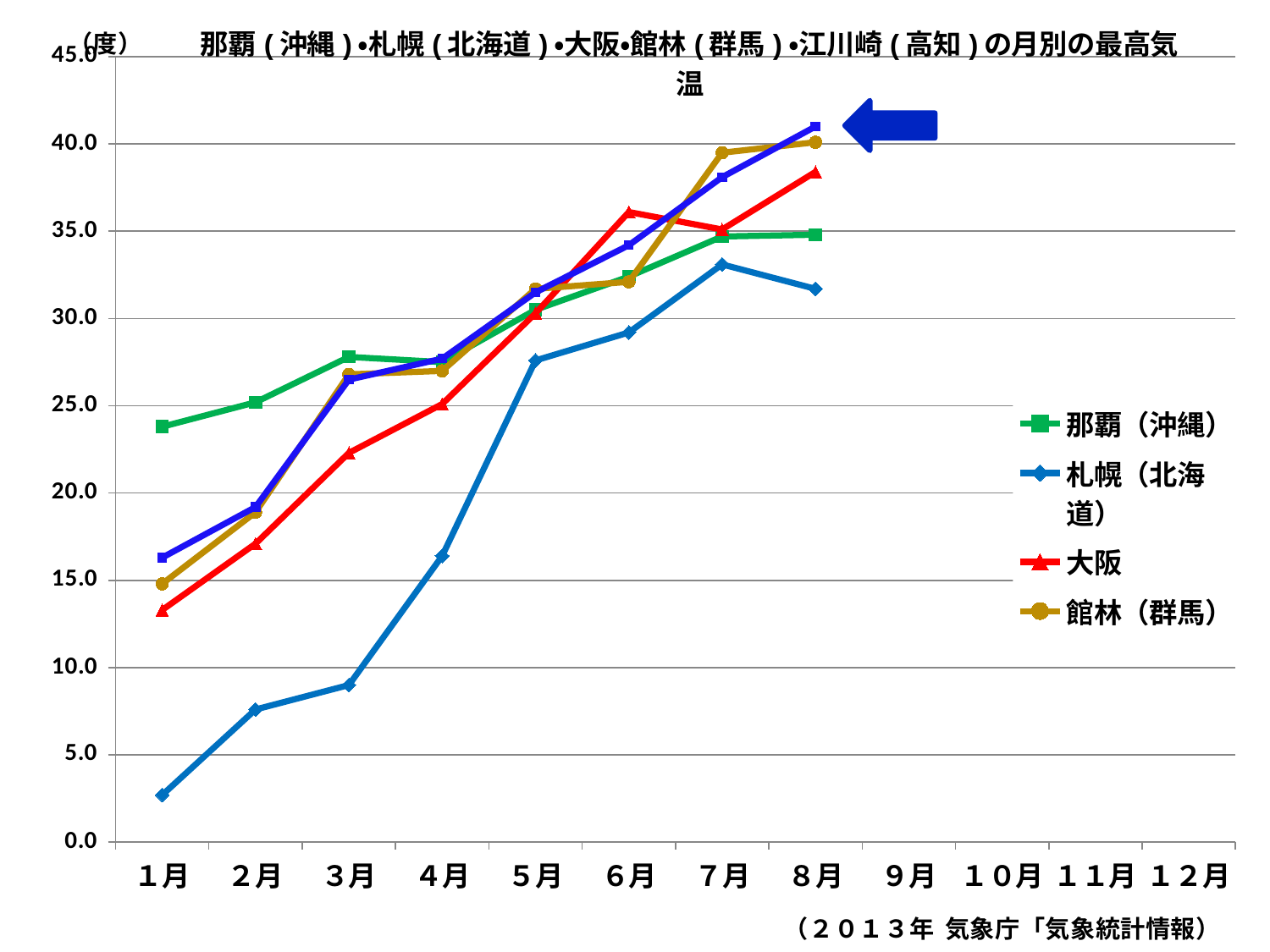
Does the value for 札幌（北海道） rise or fall from 1月 to 7月? rise Is the value for 大阪 in 8月 greater or less than 35.0? greater Which series has the lowest value in 1月? 札幌（北海道） Which year is cited in the data source note below the chart? ２０１３年 Is the value for 札幌（北海道） in 1月 greater or less than 5.0? less Is the value for 那覇（沖縄） in 1月 greater or less than 20.0? greater How many series does the legend list? 4 In 8月, which is larger: the value for 大阪 or the value for 札幌（北海道）? 大阪 How many month categories are shown on the x axis? 12 What kind of chart is shown on the slide? line chart Which series has the highest value in 1月? 那覇（沖縄）